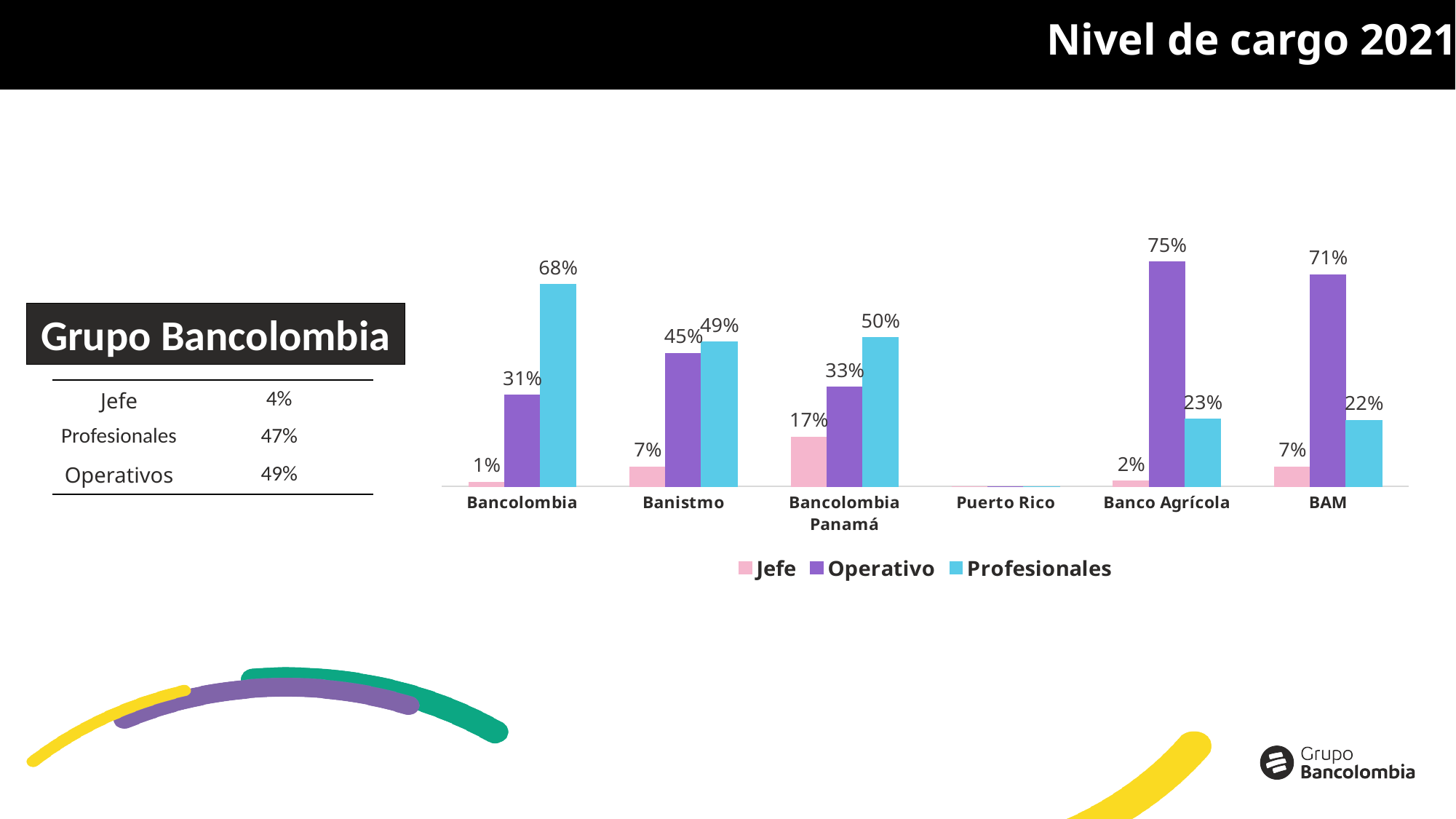
How many series does the legend list? 3 What is the Profesionales value for Bancolombia? 68% What is the Operativo value for Banco Agrícola? 75% Which category has the highest Operativo value? Banco Agrícola Which category has the highest Profesionales value? Bancolombia Which series is shown in purple in the legend? Operativo What is the difference between the Operativo and Profesionales values for Banistmo? 4% Which is larger for BAM, the Operativo value or the Profesionales value? Operativo What is the Profesionales value for BAM? 22% How many categories are shown on the x axis of the chart? 6 What is the Jefe value for Bancolombia Panamá? 17% What kind of chart is shown on the slide? Bar chart